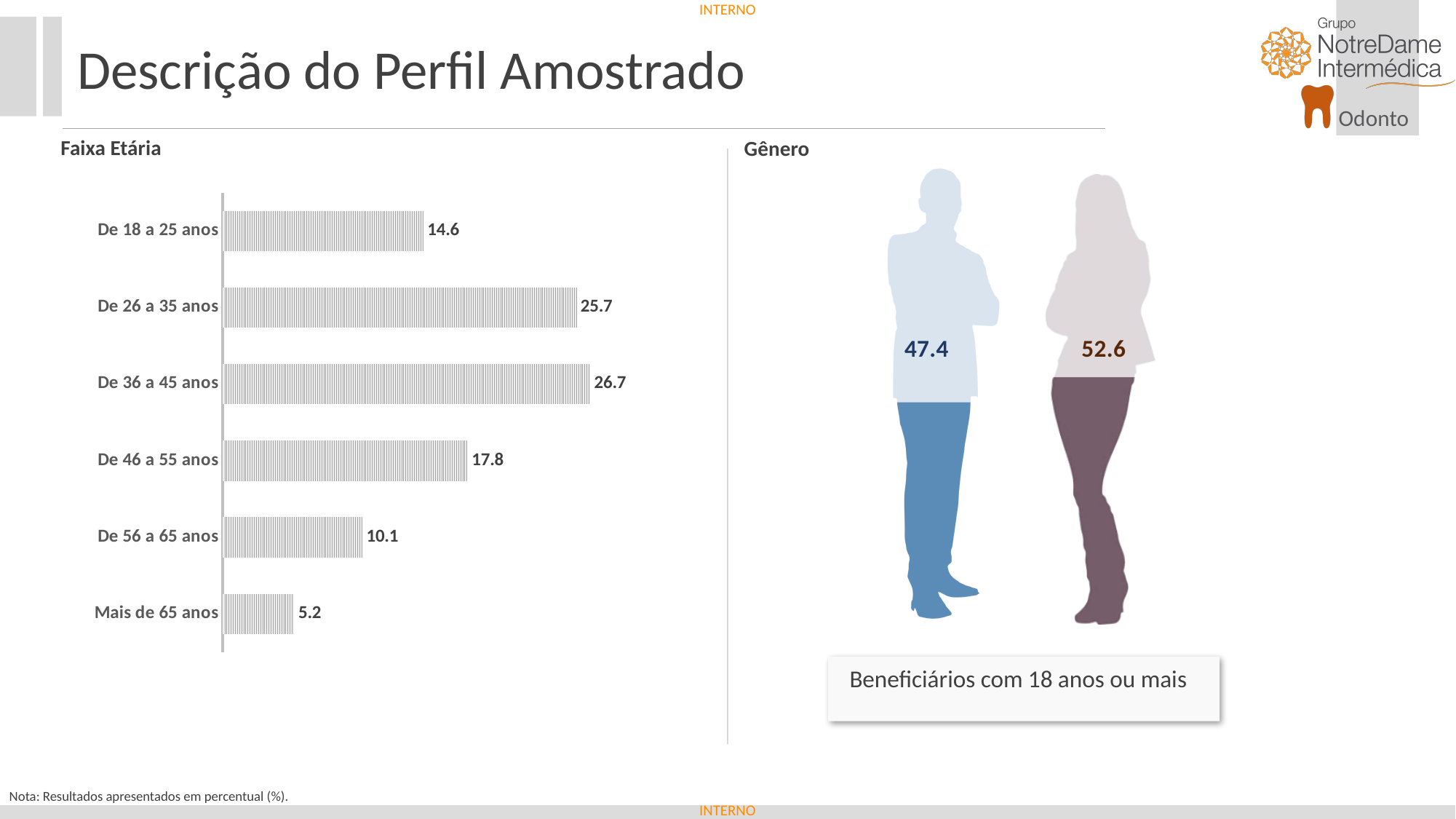
What kind of chart is the Faixa Etária chart? Bar chart In the Gênero graphic, what is the value shown for the female figure? 52.6 In the Faixa Etária chart, what is the value for Mais de 65 anos? 5.2 In the Faixa Etária chart, which is larger: De 46 a 55 anos or De 56 a 65 anos? De 46 a 55 anos How many age groups are shown in the Faixa Etária chart? 6 In the Faixa Etária chart, what is the value for De 26 a 35 anos? 25.7 In the Faixa Etária chart, which age group has the lowest value? Mais de 65 anos According to the note at the bottom of the slide, in what unit are the results presented? Percentual (%) In the Faixa Etária chart, what is the value for De 46 a 55 anos? 17.8 In the Gênero graphic, what is the value shown for the male figure? 47.4 In the Faixa Etária chart, which age group has the highest value? De 36 a 45 anos In the Faixa Etária chart, what is the difference between De 36 a 45 anos and De 18 a 25 anos? 12.1